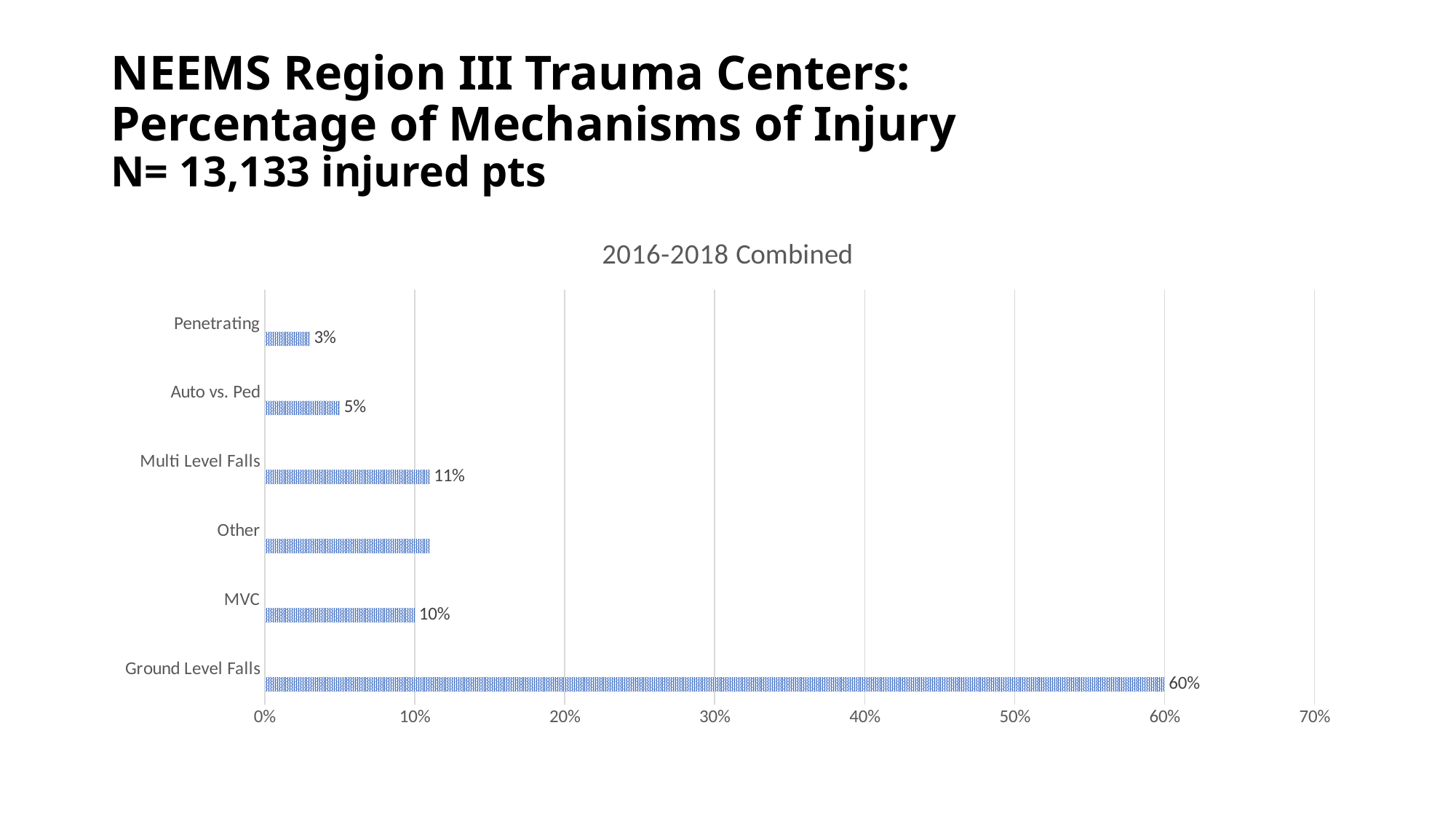
What percentage is shown for Ground Level Falls? 60% Which mechanism of injury has the lowest percentage? Penetrating What type of chart is used on this slide? bar chart What percentage is shown for Multi Level Falls? 11% Which is larger, the percentage for Multi Level Falls or for Auto vs. Ped? Multi Level Falls How many mechanism-of-injury categories are shown in the chart? 6 Is the value for Other greater or less than 20%? less What percentage is shown for MVC? 10% What is the difference in percentage points between Ground Level Falls and MVC? 50% What percentage is shown for Penetrating injuries? 3% Which mechanism of injury has the highest percentage? Ground Level Falls What percentage is shown for Auto vs. Ped? 5%